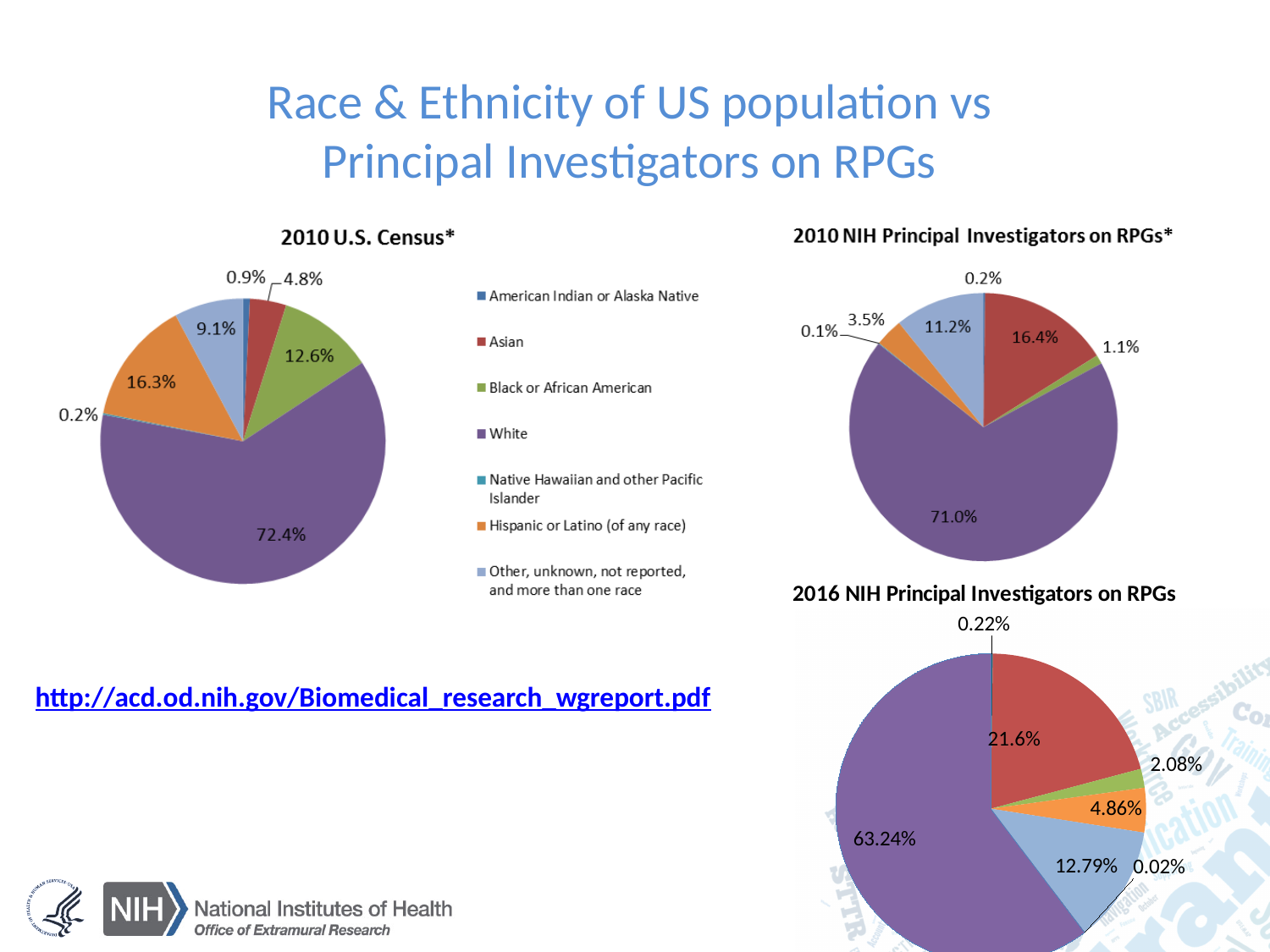
In the 2016 NIH Principal Investigators on RPGs chart, what is the largest slice's value? 63.24% In the 2016 NIH Principal Investigators on RPGs chart, what is the value of the smallest slice? 0.02% What is the title of the bottom-right chart? 2016 NIH Principal Investigators on RPGs How many categories does the shared legend list? 7 In the 2010 U.S. Census chart, what share of the pie is White? 72.4% What is the difference between the White share in the 2010 U.S. Census chart (72.4%) and in the 2010 NIH Principal Investigators chart (71.0%)? 1.4% In the 2010 NIH Principal Investigators on RPGs chart, which category has the largest share? White In the 2010 NIH Principal Investigators on RPGs chart, which category has the smallest share? Native Hawaiian and other Pacific Islander What kind of charts are shown on the slide? Pie charts Which is larger: the Black or African American share in the 2010 U.S. Census chart or in the 2010 NIH Principal Investigators on RPGs chart? 2010 U.S. Census In the 2010 U.S. Census chart, what share is Hispanic or Latino (of any race)? 16.3% In the 2010 NIH Principal Investigators on RPGs chart, what share is Asian? 16.4%